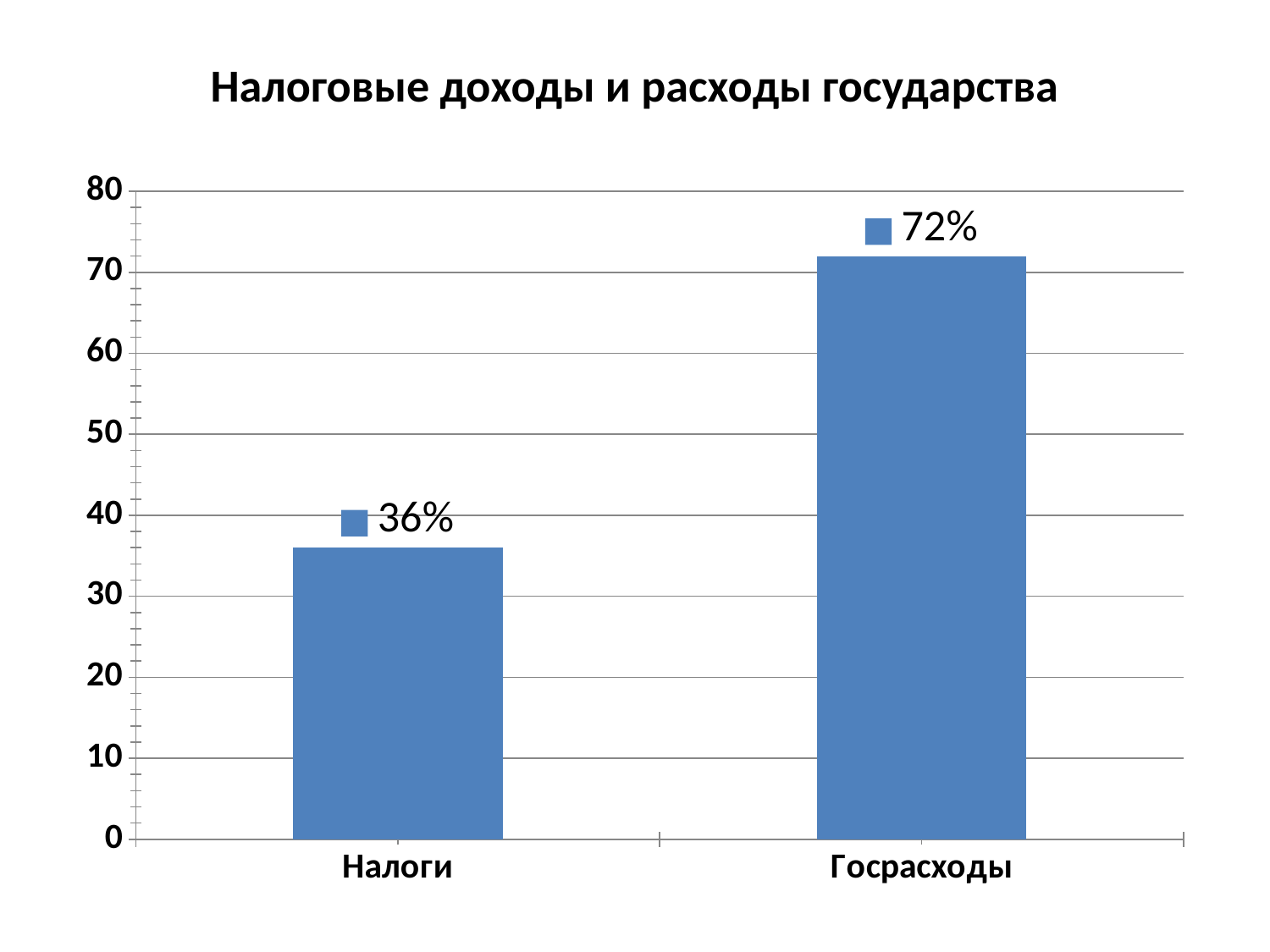
What is the maximum value shown on the vertical axis? 80 Which category has the lowest value? Налоги How many categories are shown on the x axis? 2 Which is larger, the value for Налоги or the value for Госрасходы? Госрасходы Is the value for Налоги greater or less than 40? less What is the value for Налоги? 36% What is the title of the chart? Налоговые доходы и расходы государства What is the value for Госрасходы? 72% What kind of chart is shown on the slide? bar chart Is the value for Госрасходы greater or less than 70? greater What is the difference between the values for Госрасходы and Налоги? 36% Which category has the highest value? Госрасходы